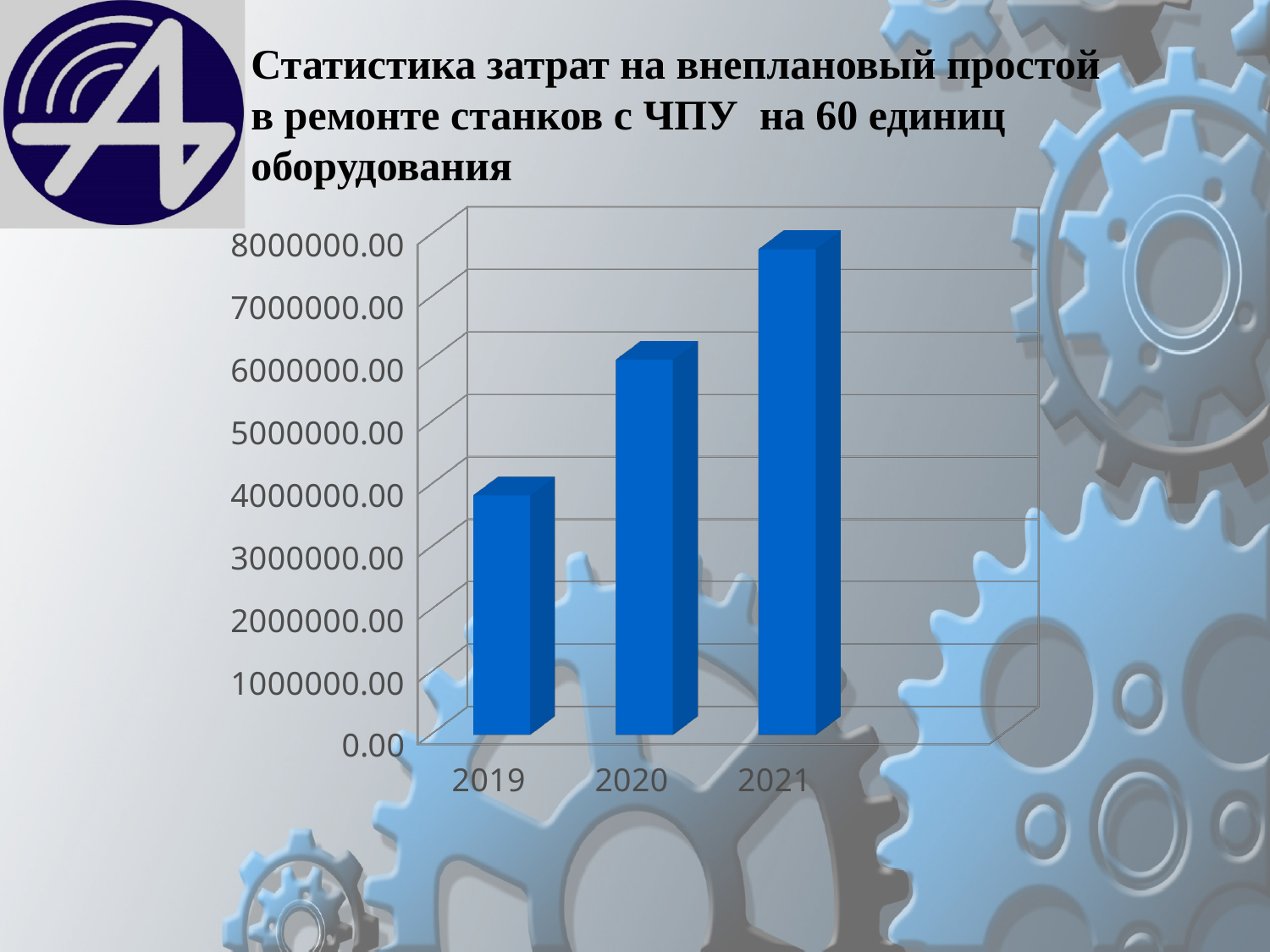
Is the value for 2021 greater or less than 7000000.00? greater What kind of chart is shown on the slide? bar chart Is the bar for 2020 taller than the bar for 2019? yes Which is larger, the value for 2021 or the value for 2020? 2021 Is the value for 2020 greater or less than 5000000.00? greater Which year has the highest bar in the chart? 2021 Is the value for 2020 greater or less than 7000000.00? less How many years (categories) are shown on the x axis of the chart? 3 Which year has the lowest bar in the chart? 2019 What is the highest tick value shown on the vertical axis of the chart? 8000000.00 Do the values rise or fall from 2019 to 2021? rise